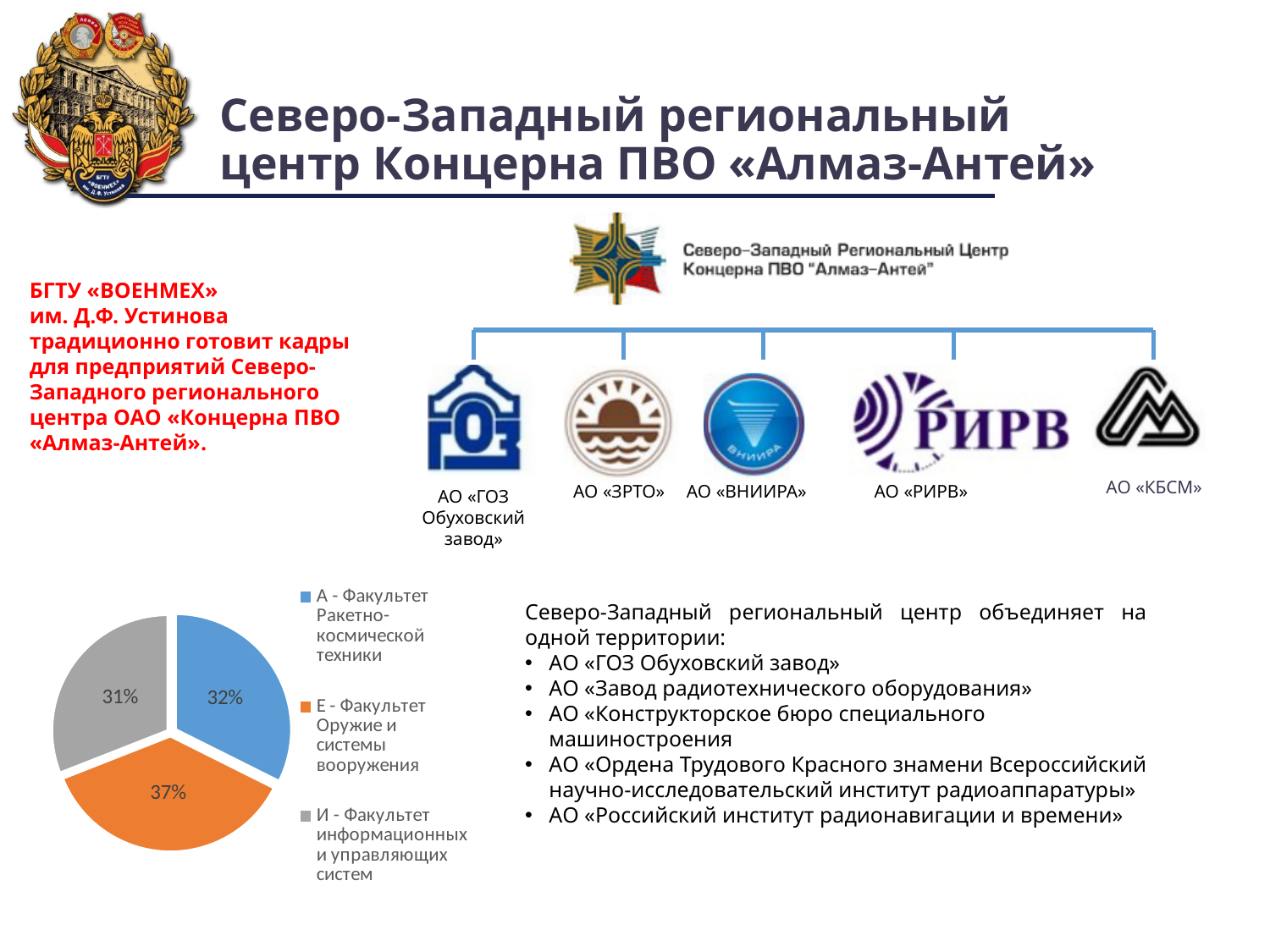
How many slices does the pie chart have? 3 What share of the pie chart does "Е - Факультет Оружие и системы вооружения" have? 37% What share of the pie chart does "И - Факультет информационных и управляющих систем" have? 31% How many entries does the legend of the pie chart list? 3 What colour is the slice for "А - Факультет Ракетно-космической техники" in the pie chart? blue What is the difference in percentage points between the slices for "Е - Факультет Оружие и системы вооружения" and "И - Факультет информационных и управляющих систем"? 6 What kind of chart is shown on the slide? pie chart What colour is the slice for "И - Факультет информационных и управляющих систем" in the pie chart? grey Which slice is larger in the pie chart: "А - Факультет Ракетно-космической техники" or "Е - Факультет Оружие и системы вооружения"? Е - Факультет Оружие и системы вооружения Which faculty has the smallest slice in the pie chart? И - Факультет информационных и управляющих систем Which faculty has the largest slice in the pie chart? Е - Факультет Оружие и системы вооружения What share of the pie chart does "А - Факультет Ракетно-космической техники" have? 32%